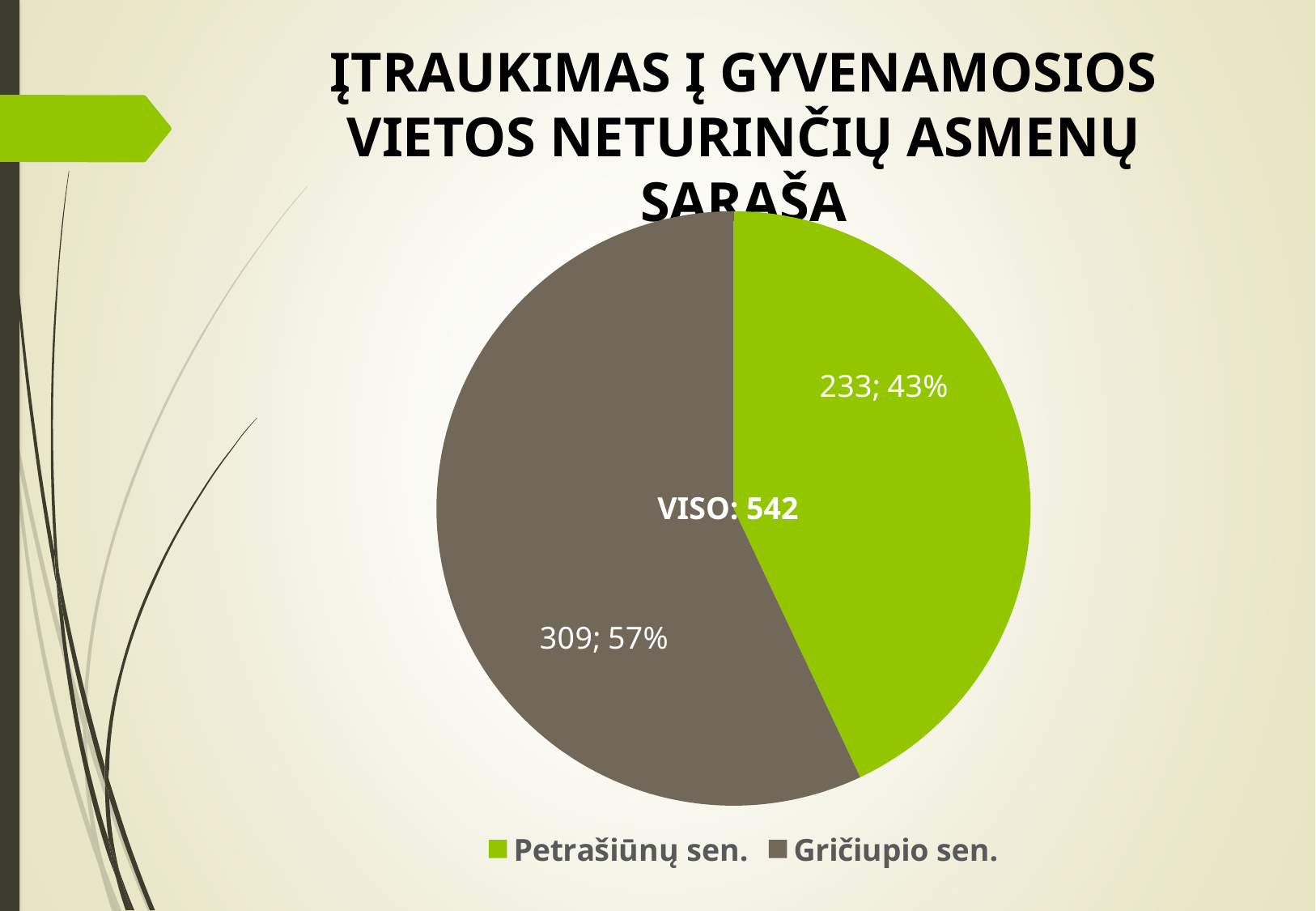
What is the value for Petrašiūnų sen.? 233 What total is printed in the centre of the pie chart? VISO: 542 How many slices does the pie chart have? 2 Which colour represents Petrašiūnų sen. in the chart? green What share of the pie does Gričiupio sen. represent? 57% What kind of chart is shown on the slide? pie chart Which category has the largest slice? Gričiupio sen. What is the value for Gričiupio sen.? 309 What share of the pie does Petrašiūnų sen. represent? 43% What is the difference between the values for Gričiupio sen. and Petrašiūnų sen.? 76 Which category has the smallest slice? Petrašiūnų sen. How many entries does the legend list? 2